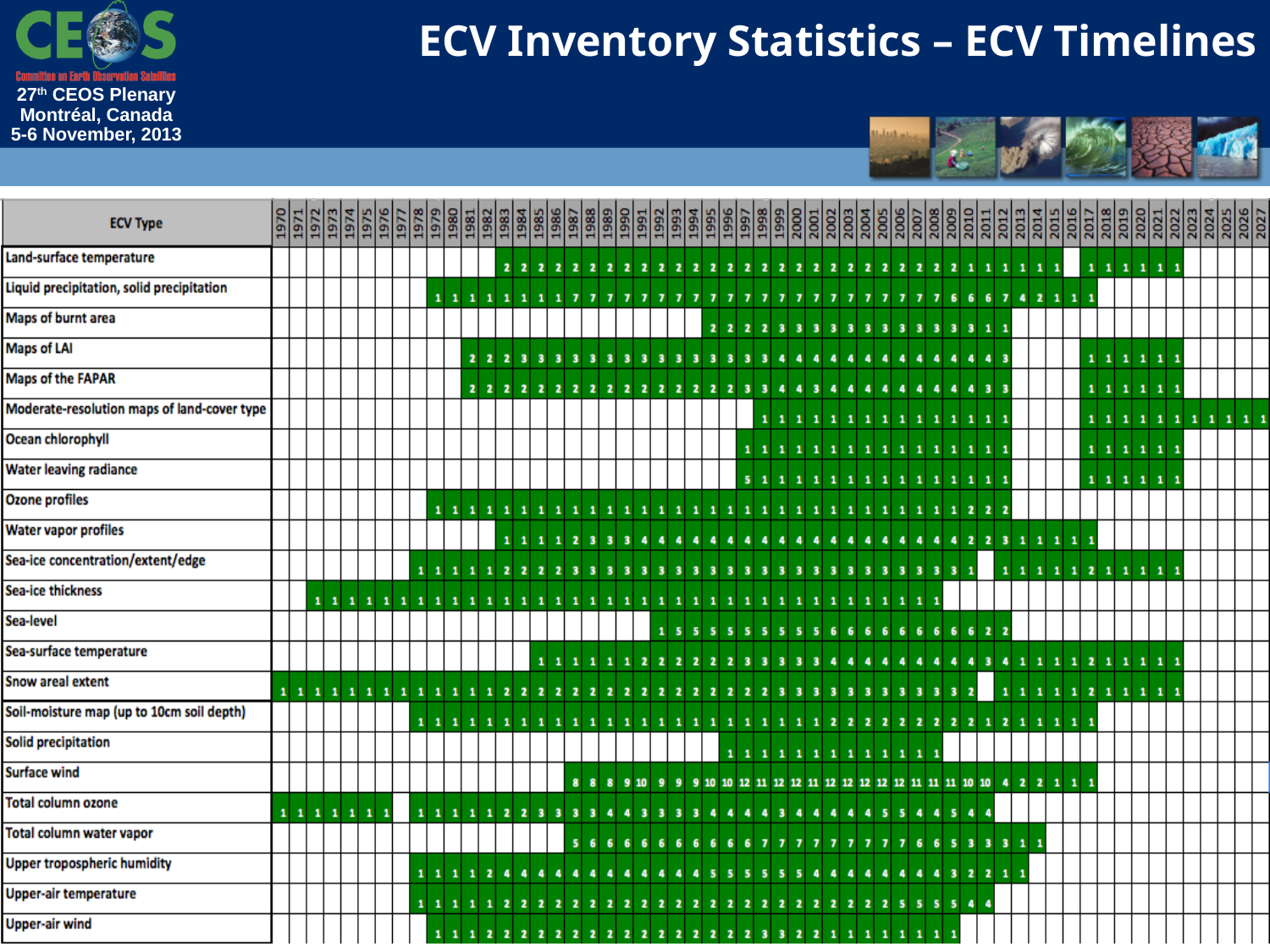
What is the highest count shown in the Maps of burnt area row? 3 How many ECV types are listed as rows in the timeline chart? 23 What is the last year shown on the timeline's year axis? 2027 What kind of chart is shown on the slide? timeline table (heatmap grid) Which ECV type reaches the highest single-year count in the timeline? Surface wind What is the first year shown on the timeline's year axis? 1970 What is the highest count shown in the Sea-level row? 6 Which ECV type's timeline extends all the way to 2027? Moderate-resolution maps of land-cover type Which has the larger peak count, Surface wind or Sea-level? Surface wind What is the highest count shown in the Surface wind row? 12 What is the title of the chart on the slide? ECV Inventory Statistics – ECV Timelines What is the difference between the peak count for Surface wind and the peak count for Sea-level? 6